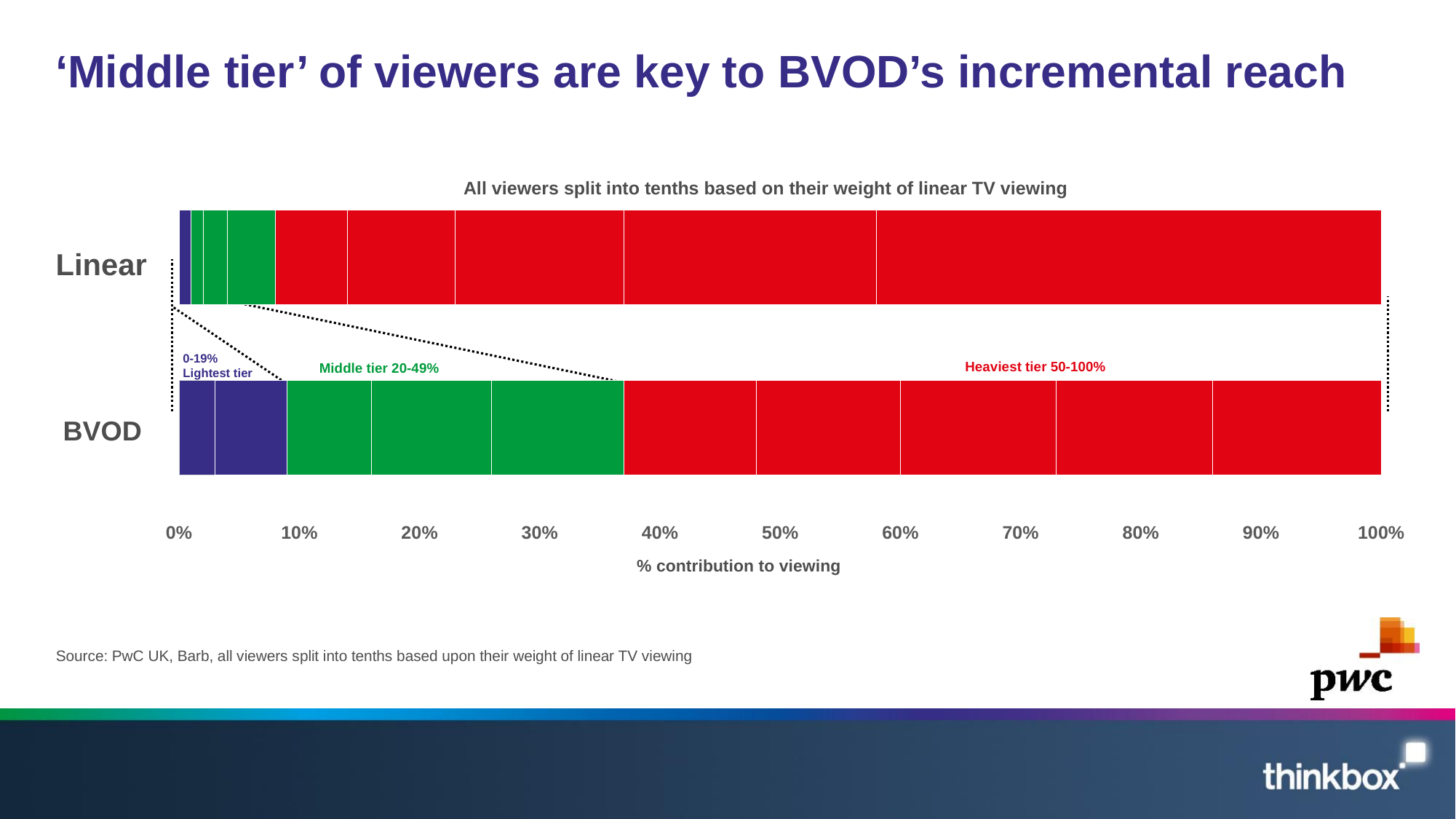
Which bar, Linear or BVOD, has the larger contribution from the heaviest tier (50-100%) of viewers? Linear What is the label of the x axis? % contribution to viewing Is the combined contribution of the lightest and middle tiers for BVOD greater or less than 30%? greater Which colour represents the heaviest tier (50-100%) of viewers? Red Is the contribution of the lightest tier (0-19%) for BVOD greater or less than 10%? less Is the contribution of the heaviest tier for Linear greater or less than 80%? greater Which bar, Linear or BVOD, has the larger contribution from the middle tier (20-49%) of viewers? BVOD What kind of chart is shown on the slide? Stacked bar chart Into how many segments is each bar split? 10 How many categories (bars) does the chart show? 2